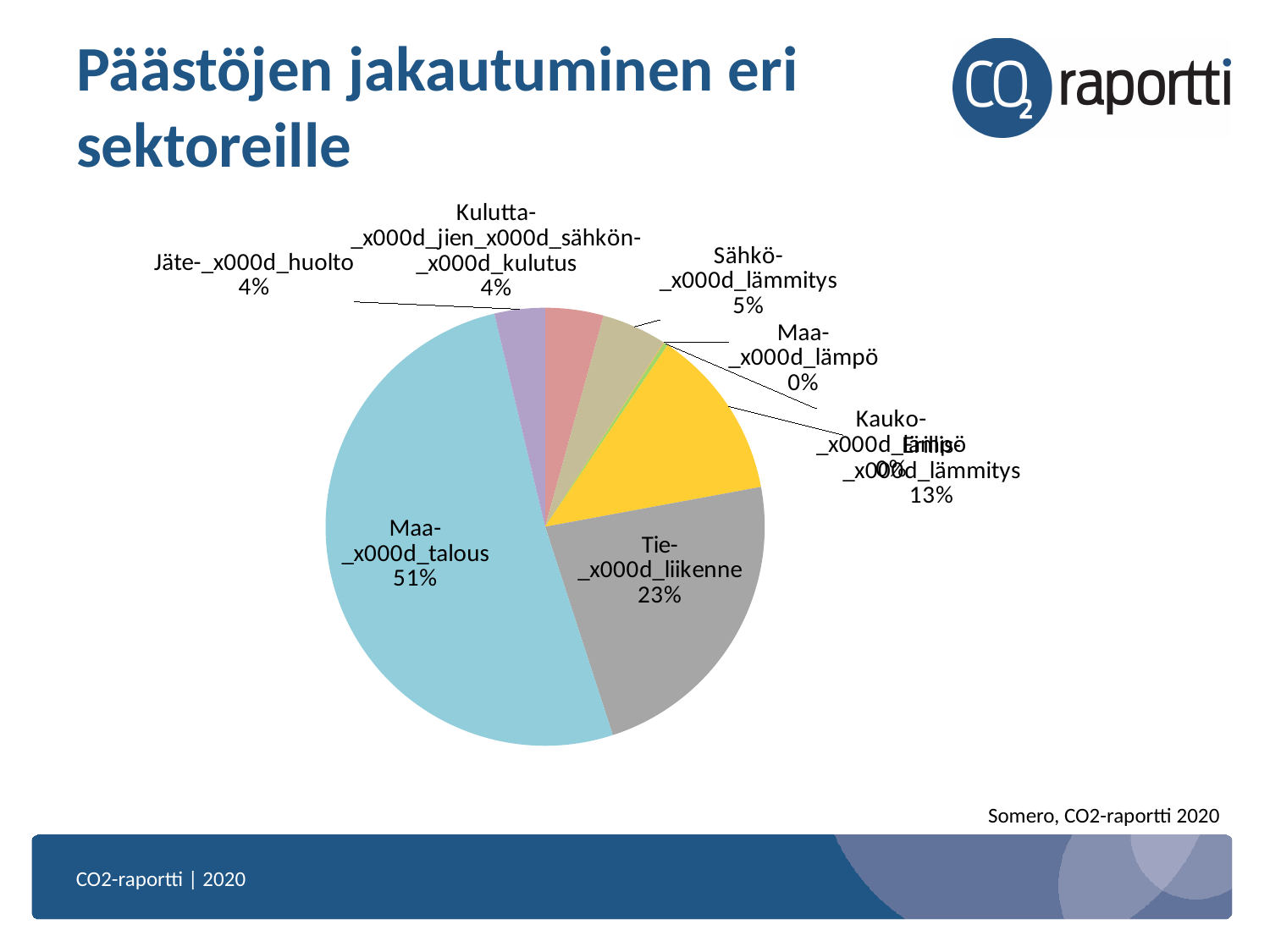
What share of emissions does the Maatalous (Maa-_x000d_talous) slice represent? 51% What percentage is shown for Sähkölämmitys (Sähkö-_x000d_lämmitys)? 5% What share of emissions does the Tieliikenne (Tie-_x000d_liikenne) slice represent? 23% Which sector has the largest share of emissions in the pie chart? Maatalous (Maa-_x000d_talous) What percentage is shown for Maalämpö (Maa-_x000d_lämpö)? 0% What is the title of the slide containing the pie chart? Päästöjen jakautuminen eri sektoreille What is the difference in percentage points between the Maatalous share and the Tieliikenne share? 28 percentage points What percentage is shown for Kuluttajien sähkönkulutus (Kulutta-_x000d_jien_x000d_sähkön-_x000d_kulutus)? 4% How many sectors (slices) are labelled in the pie chart? 8 What type of chart is shown on the slide? Pie chart What percentage is shown for Jätehuolto (Jäte-_x000d_huolto)? 4% Which is larger, the share for Tieliikenne or the share for Sähkölämmitys? Tieliikenne